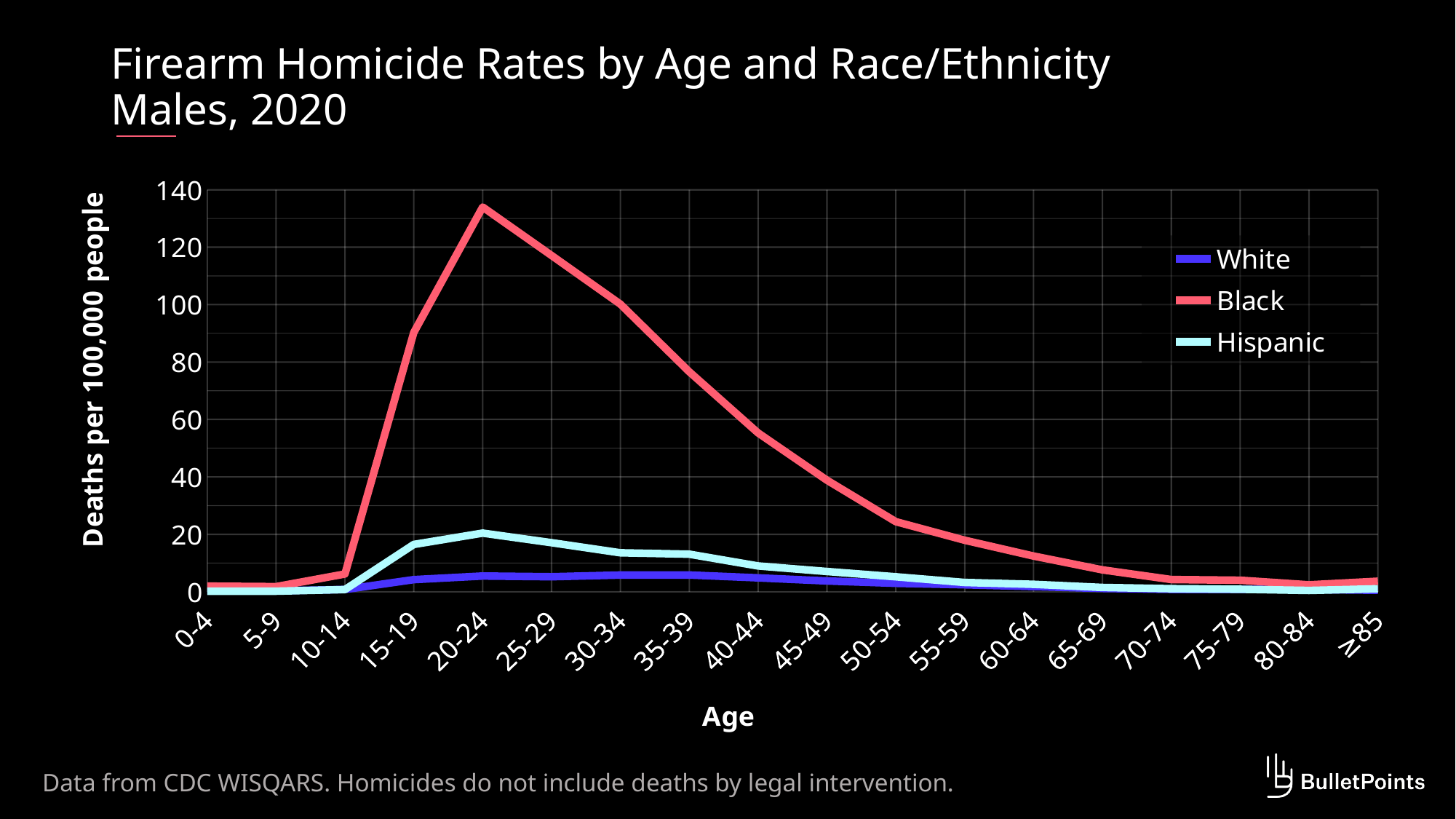
Which series has the higher value for ages 20-24, Black or Hispanic? Black How many age categories are shown on the x axis? 18 Is the value for Black males aged 20-24 greater or less than 120? greater Does the Black series rise or fall from ages 20-24 to ages 70-74? Fall Is the value for Hispanic males aged 30-34 greater or less than 20? less Which series has the higher value for ages 15-19, White or Hispanic? Hispanic Is the value for Black males aged 15-19 greater or less than 80? greater How many series does the legend list? 3 What kind of chart is shown on the slide? Line chart What is the label of the y axis? Deaths per 100,000 people For which age group does the Black series reach its highest value? 20-24